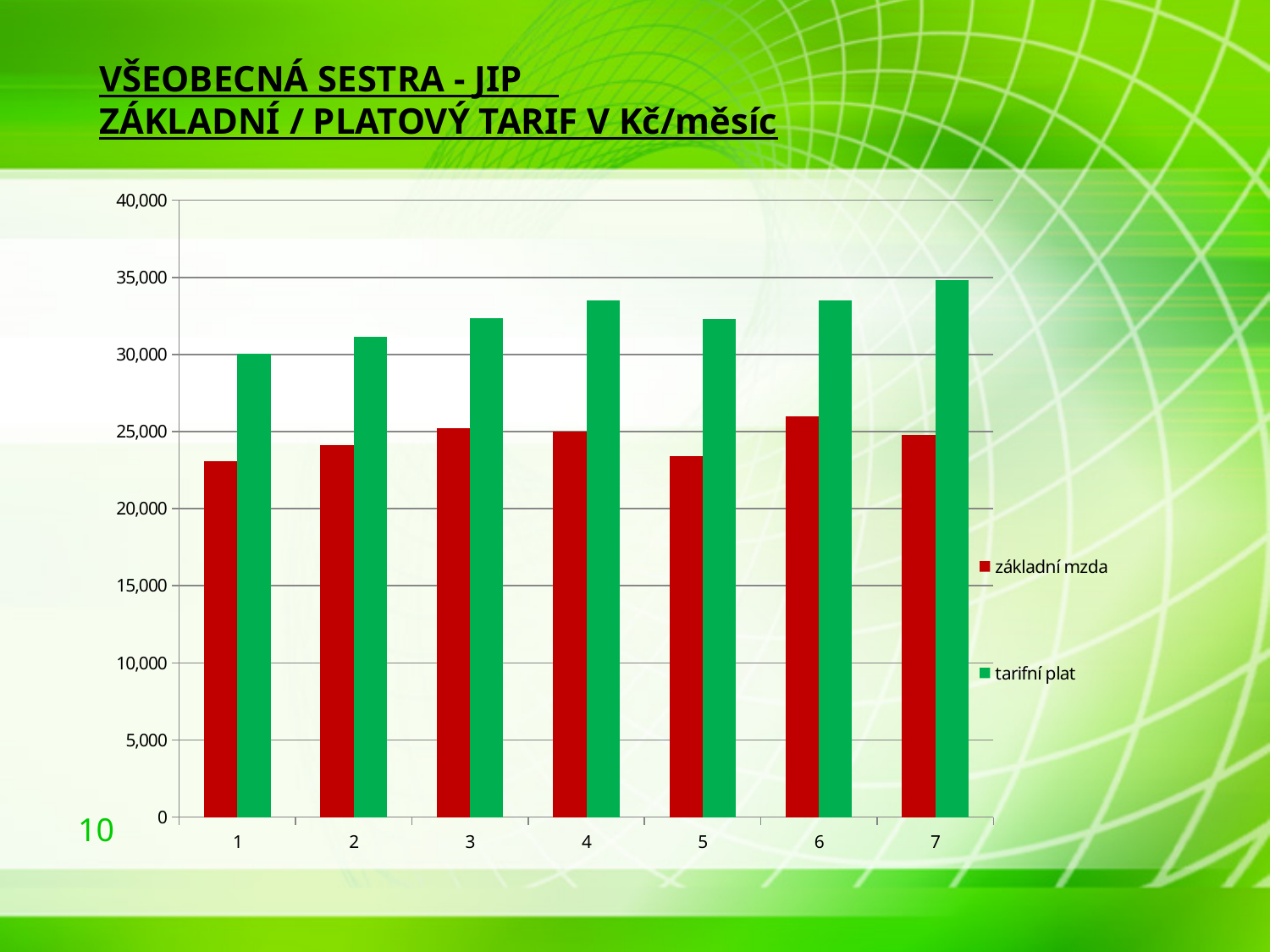
Is the value of tarifní plat for category 4 greater or less than 30,000? greater Which category has the lowest value for tarifní plat? 1 Which category has the highest value for základní mzda? 6 How many series does the legend list? 2 What are the two series named in the legend? základní mzda and tarifní plat What kind of chart is shown on the slide? bar chart Which series is shown in green? tarifní plat For category 4, which is larger: základní mzda or tarifní plat? tarifní plat Which category has the highest value for tarifní plat? 7 Is the value of základní mzda for category 1 greater or less than 25,000? less How many categories are shown on the x axis? 7 Is the value of základní mzda for category 6 greater or less than 25,000? greater